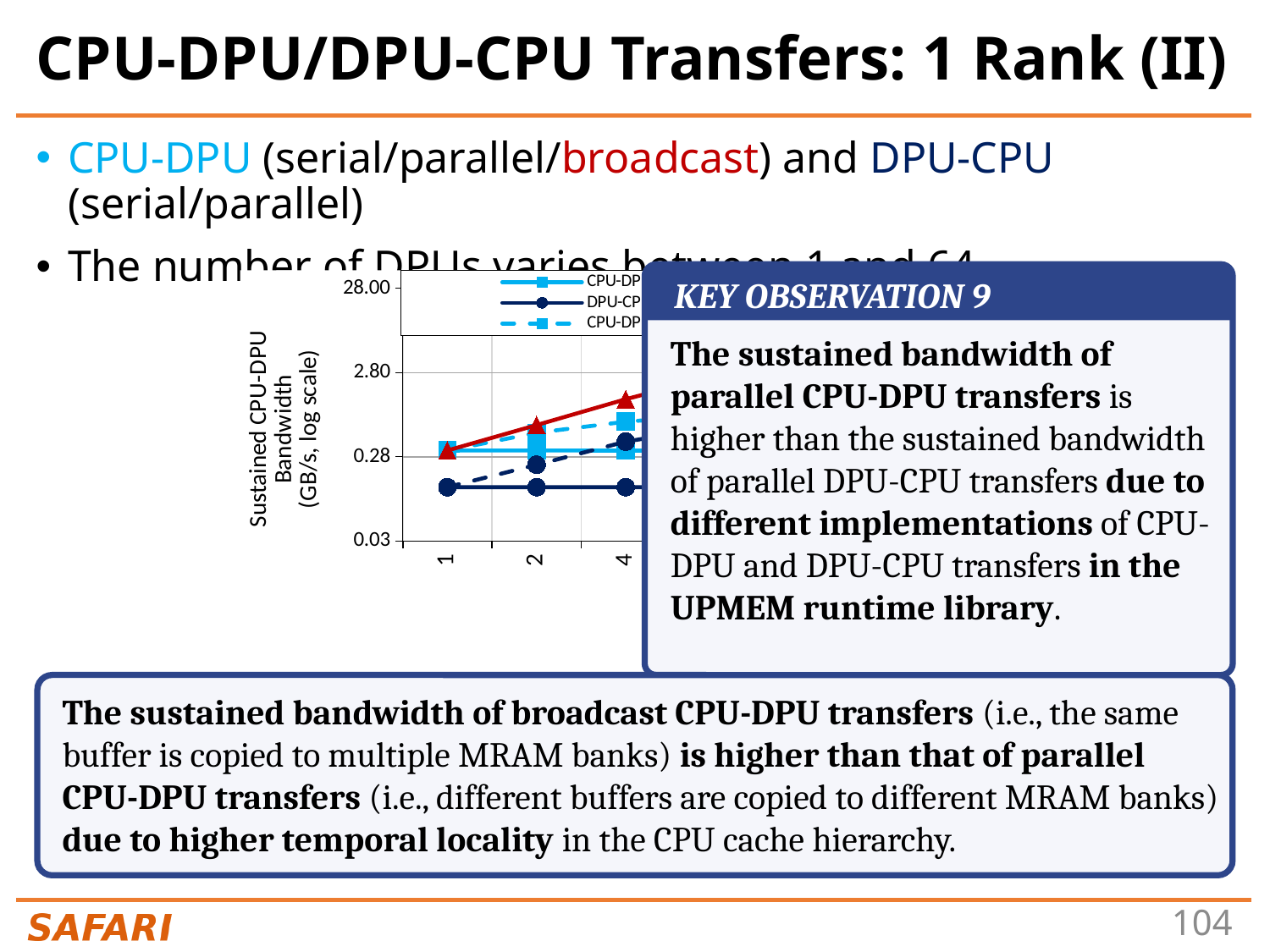
What kind of chart is shown on the slide? line chart Is the value of the solid red line with triangle markers at x = 4 greater or less than 0.28? greater Is the value of the solid red line with triangle markers at x = 4 greater or less than 2.80? less Does the solid dark blue line with circle markers rise, fall, or stay flat between x = 1 and x = 4? stay flat What is the highest tick value shown on the y-axis of the chart? 28.00 At x = 4, which is larger: the solid red line with triangle markers or the solid dark blue line with circle markers? the solid red line with triangle markers What is the label on the y-axis of the chart? Sustained CPU-DPU Bandwidth (GB/s, log scale) Is the value of the solid dark blue line with circle markers at x = 1 greater or less than 0.28? less Does the solid red line with triangle markers rise or fall as the number of DPUs increases from 1 to 4? rise